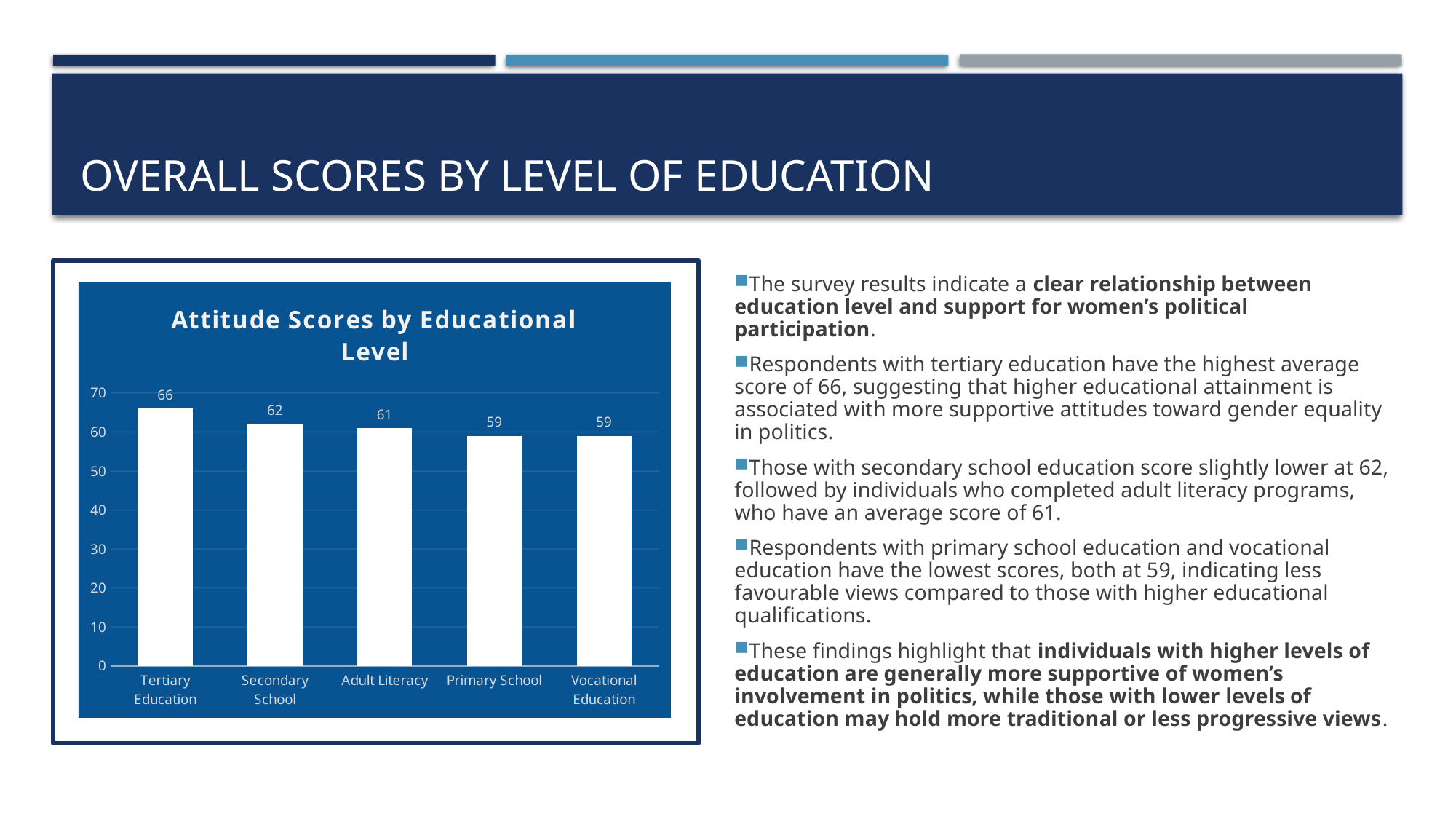
What is the title of the chart? Attitude Scores by Educational Level Which has a higher score, Secondary School or Vocational Education? Secondary School What is the attitude score for Adult Literacy? 61 What is the difference between the scores for Adult Literacy and Primary School? 2 Which educational level has the highest attitude score? Tertiary Education Do the scores rise or fall from left to right across the educational levels? Fall What is the difference between the scores for Tertiary Education and Secondary School? 4 What is the attitude score for Tertiary Education? 66 Is the value for Primary School greater or less than 50? greater What kind of chart is shown on the slide? Bar chart How many educational levels are shown in the chart? 5 What is the attitude score for Secondary School? 62